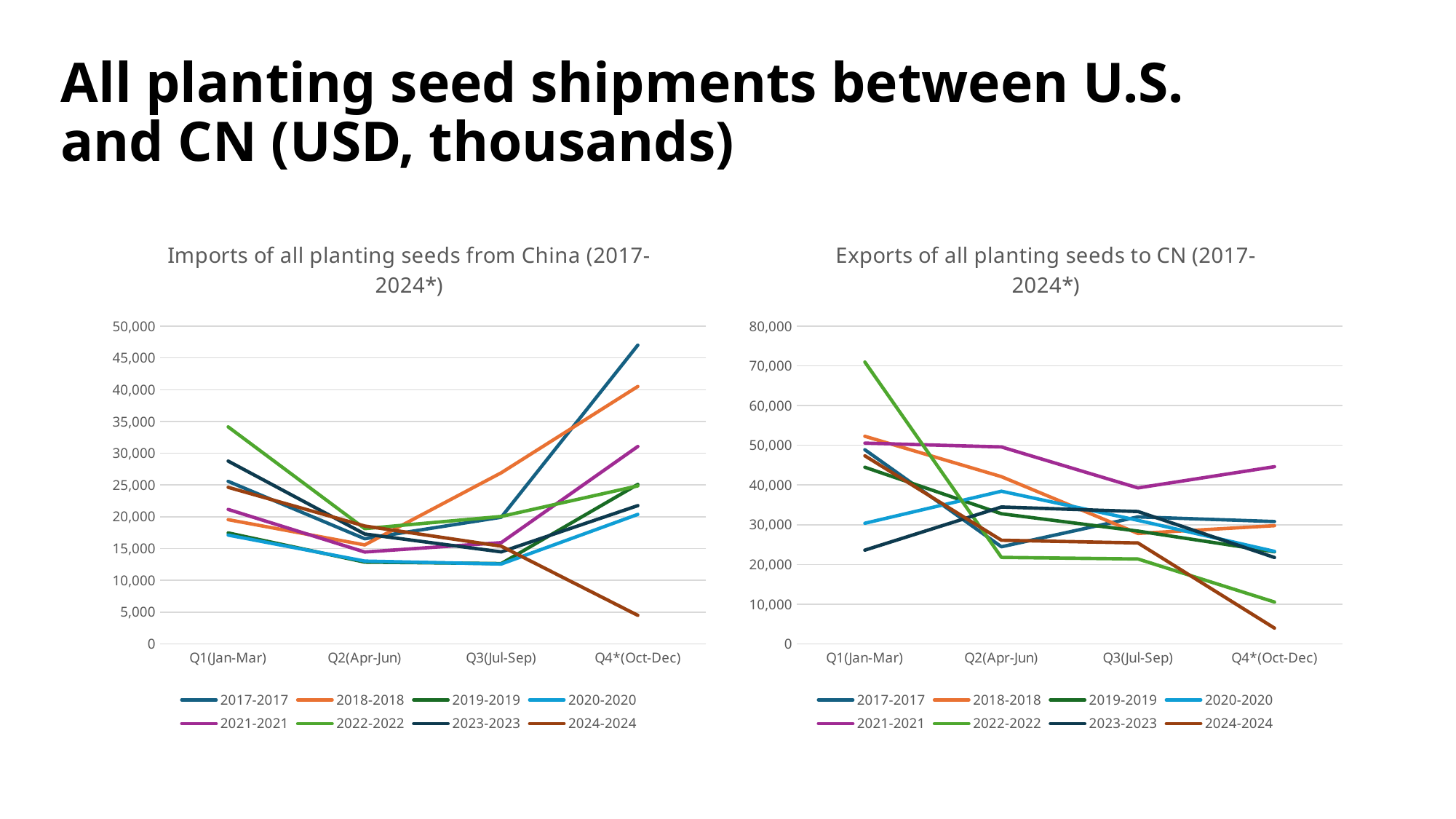
In the 'Exports of all planting seeds to CN (2017-2024*)' chart, is the value for 2022-2022 at Q1(Jan-Mar) greater or less than 60,000? greater In the 'Imports of all planting seeds from China (2017-2024*)' chart, is the value for 2017-2017 at Q4*(Oct-Dec) greater or less than 45,000? greater In the 'Imports of all planting seeds from China (2017-2024*)' chart, is the value for 2024-2024 at Q4*(Oct-Dec) greater or less than 10,000? less How many quarters are shown on the x axis of the 'Imports of all planting seeds from China (2017-2024*)' chart? 4 In the 'Exports of all planting seeds to CN (2017-2024*)' chart, which series has the highest value at Q1(Jan-Mar)? 2022-2022 What type of chart is the 'Imports of all planting seeds from China (2017-2024*)' chart? line chart In the 'Exports of all planting seeds to CN (2017-2024*)' chart, which series has the highest value at Q4*(Oct-Dec)? 2021-2021 How many series does the legend of the 'Exports of all planting seeds to CN (2017-2024*)' chart list? 8 In the 'Imports of all planting seeds from China (2017-2024*)' chart, which series has the highest value at Q4*(Oct-Dec)? 2017-2017 In the 'Imports of all planting seeds from China (2017-2024*)' chart, which series has the lowest value at Q4*(Oct-Dec)? 2024-2024 In the 'Exports of all planting seeds to CN (2017-2024*)' chart, does the 2022-2022 line rise or fall from Q1(Jan-Mar) to Q4*(Oct-Dec)? fall